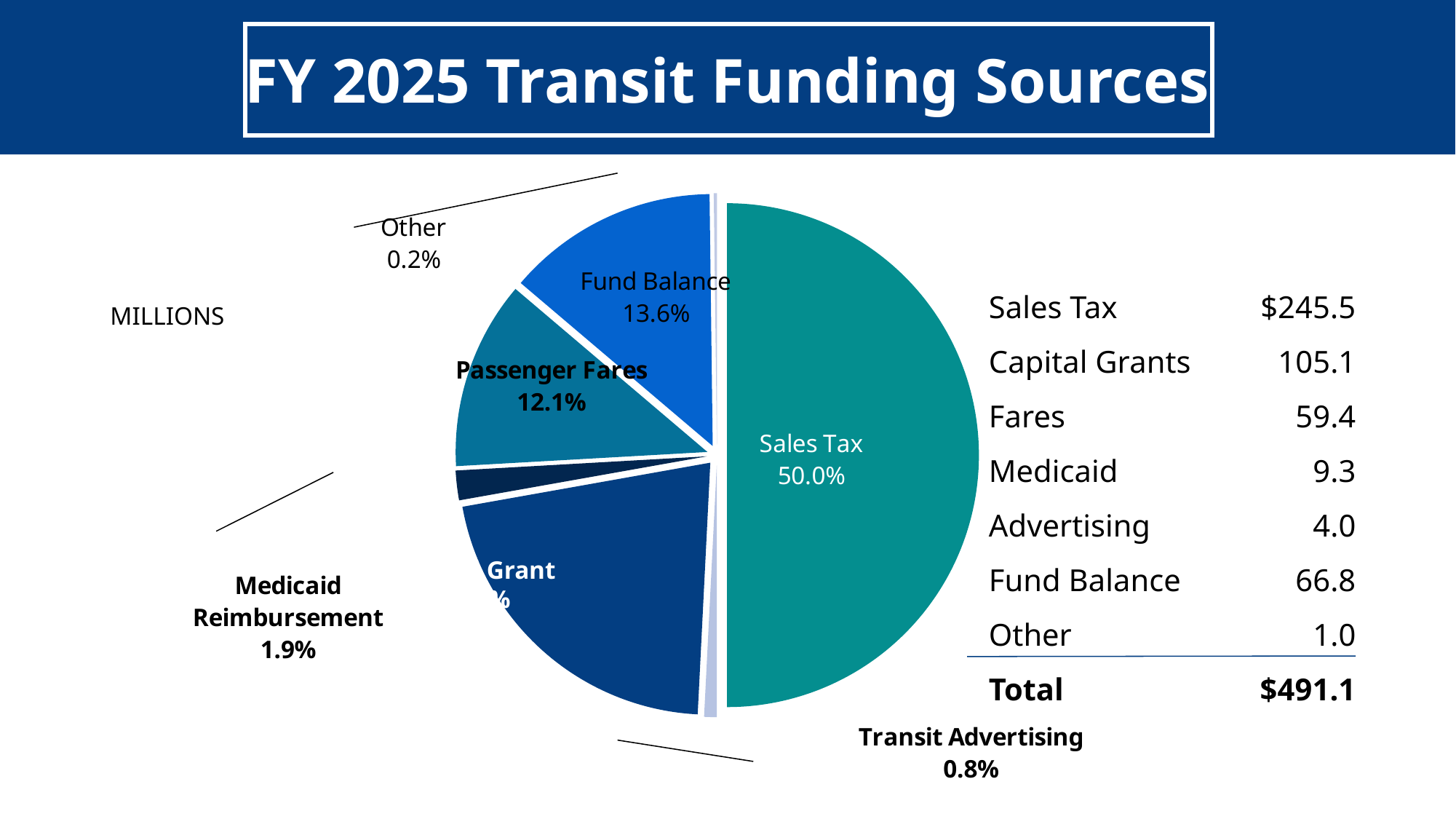
Which slice of the pie chart is the largest? Sales Tax What percentage is shown for Medicaid Reimbursement in the pie chart? 1.9% Which slice of the pie chart is the smallest? Other What is the difference in percentage points between Fund Balance and Passenger Fares in the pie chart? 1.5 How many slices does the pie chart have? 7 What share of the pie does Sales Tax represent? 50.0% What percentage is shown for Passenger Fares in the pie chart? 12.1% What percentage is shown for Fund Balance in the pie chart? 13.6% What kind of chart is shown on the slide? Pie chart Which is larger in the pie chart, Fund Balance or Passenger Fares? Fund Balance What is the difference in percentage points between Transit Advertising and Other in the pie chart? 0.6 What is the title of the slide's chart? FY 2025 Transit Funding Sources